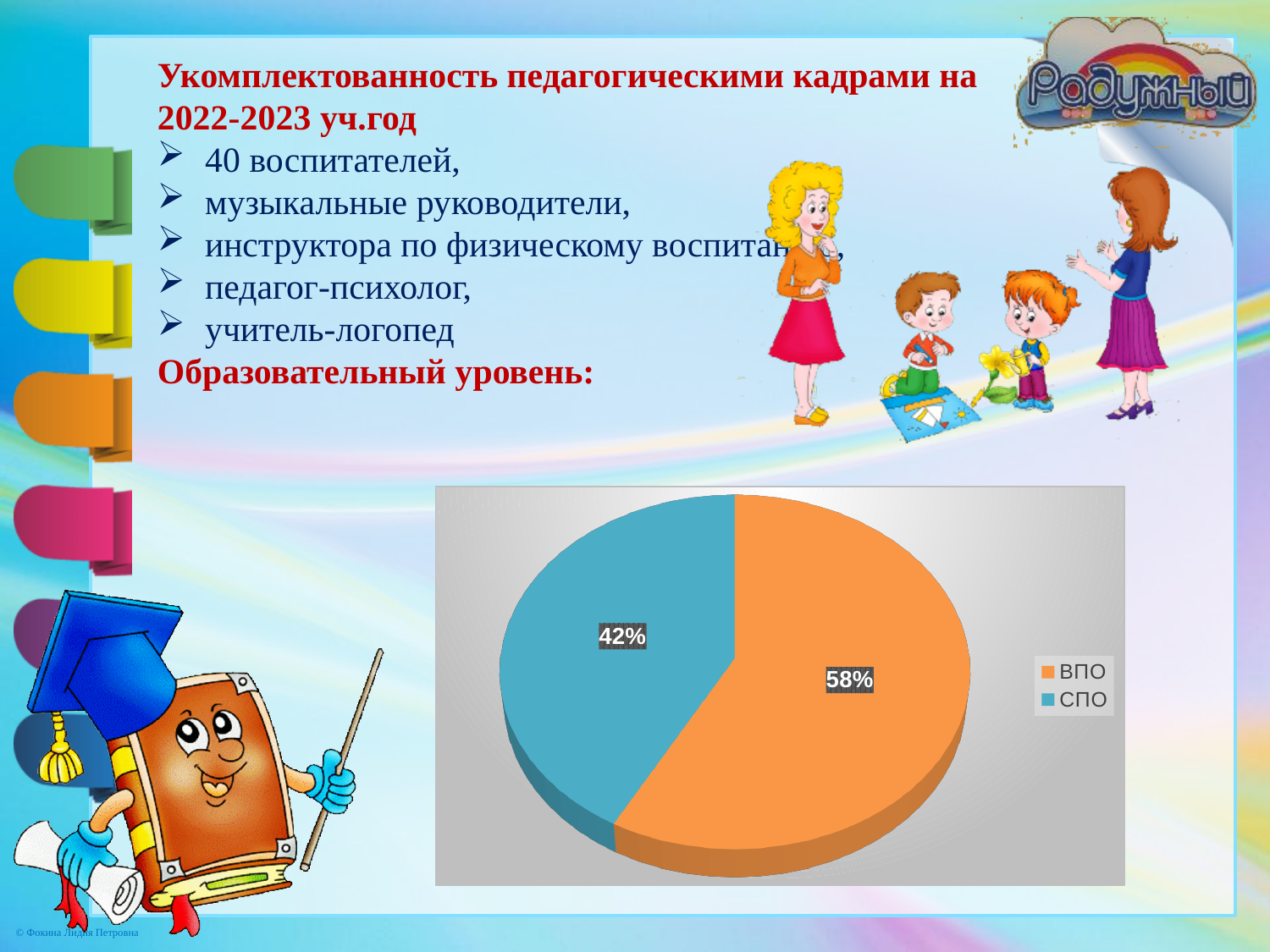
What share of the pie does ВПО have? 58% Is the share for СПО greater or less than 50%? less What colour is the СПО slice in the pie chart? blue Which category has the smallest slice of the pie? СПО What is the difference in percentage points between the ВПО and СПО slices? 16 What share of the pie does СПО have? 42% How many slices does the pie chart have? 2 Which slice is larger, ВПО or СПО? ВПО Which category has the largest slice of the pie? ВПО What kind of chart is shown on the slide? pie chart How many entries does the legend of the pie chart list? 2 What colour is the ВПО slice in the pie chart? orange